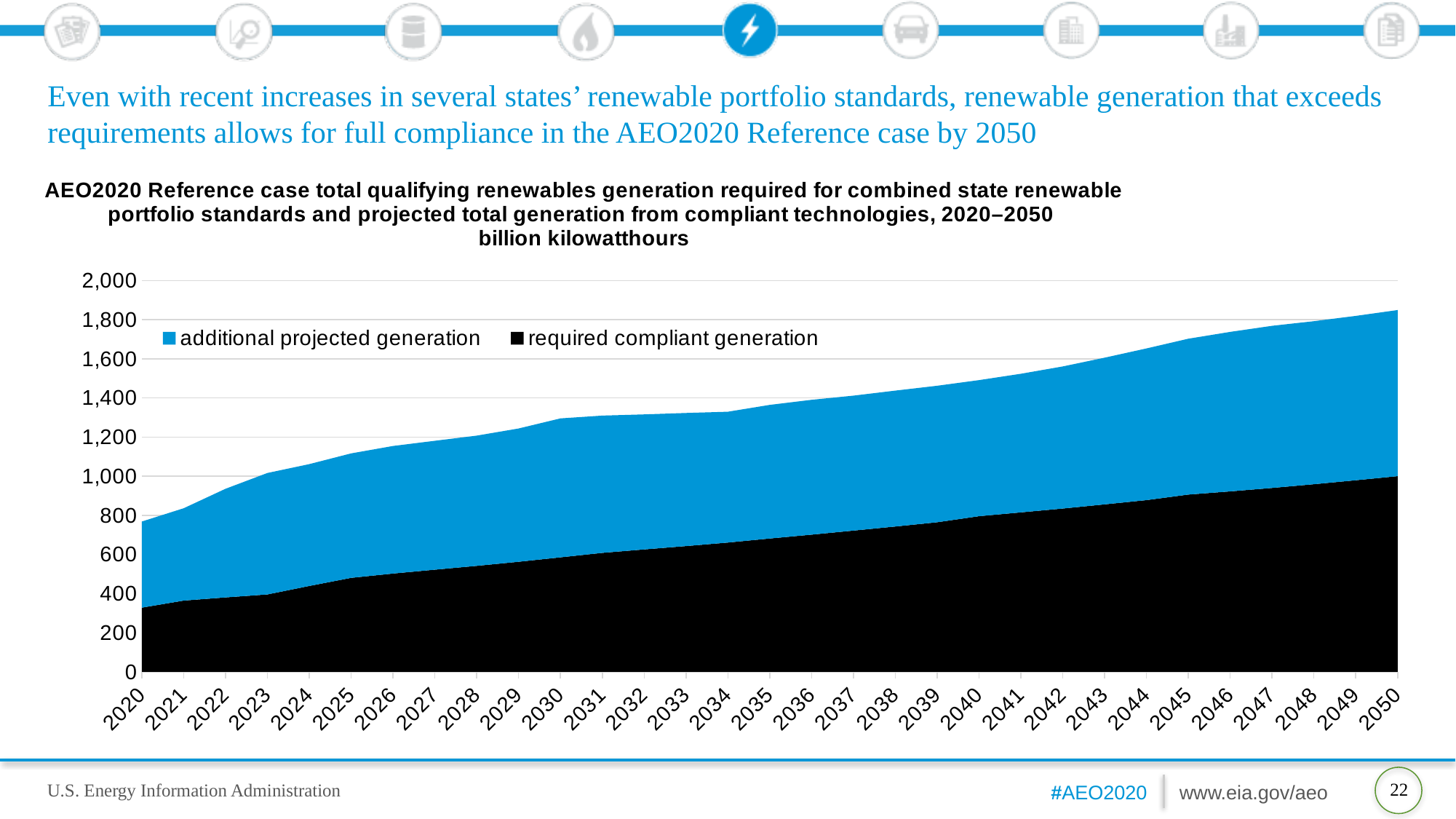
In what unit are the values on the chart expressed? billion kilowatthours Is the total of the stacked areas in 2050 greater or less than 1,800? greater Is the value for required compliant generation in 2020 greater or less than 400? less How many years are plotted along the x axis? 31 Does the required compliant generation rise or fall over the period 2020 to 2050? Rise Is the total of the stacked areas in 2030 greater or less than 1,200? greater Does the total qualifying renewables generation rise or fall from 2020 to 2050? Rise How many series does the legend list? 2 Which colour represents additional projected generation in the chart? Blue What kind of chart is shown on the slide? Stacked area chart